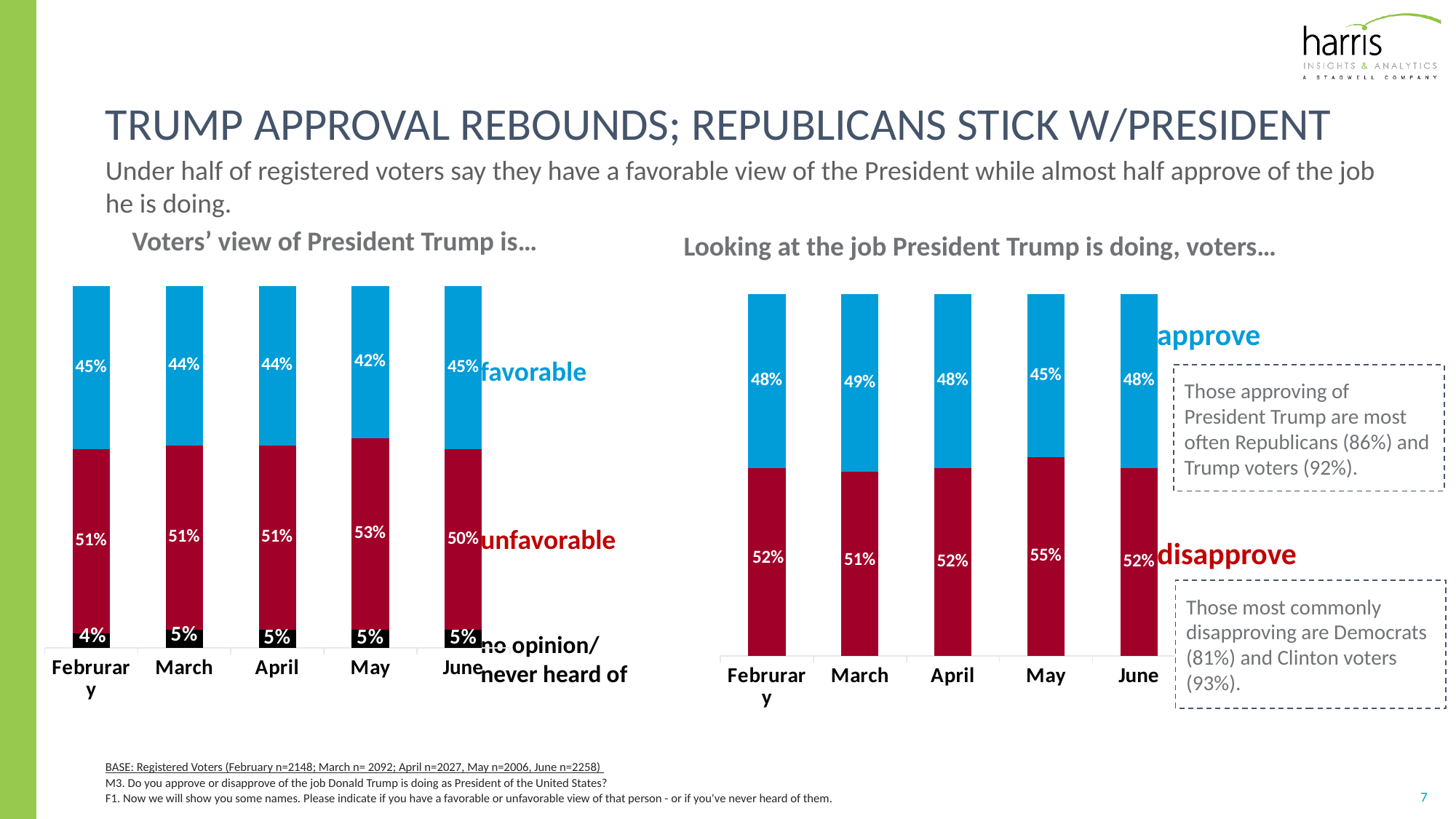
In the chart titled "Looking at the job President Trump is doing, voters...", which month has the highest disapprove value? May How many months are shown on the x axis of the chart titled "Looking at the job President Trump is doing, voters..."? 5 In the chart titled "Looking at the job President Trump is doing, voters...", what percentage approved in March? 49% In the chart titled "Voters' view of President Trump is...", what is the total of the February bar (favorable, unfavorable and no opinion/never heard of)? 100% What kind of chart is the chart titled "Looking at the job President Trump is doing, voters..."? stacked bar chart In the chart titled "Looking at the job President Trump is doing, voters...", what is the difference between the disapprove and approve values in May? 10% In the chart titled "Voters' view of President Trump is...", what percentage of voters had a favorable view in May? 42% In the chart titled "Voters' view of President Trump is...", what percentage had no opinion/never heard of in February? 4% In the chart titled "Looking at the job President Trump is doing, voters...", what colour represents the approve series? blue How many series are shown in the chart titled "Voters' view of President Trump is..."? 3 In the chart titled "Voters' view of President Trump is...", is the unfavorable value in June larger or smaller than the favorable value in June? larger In the chart titled "Voters' view of President Trump is...", which month has the lowest favorable value? May